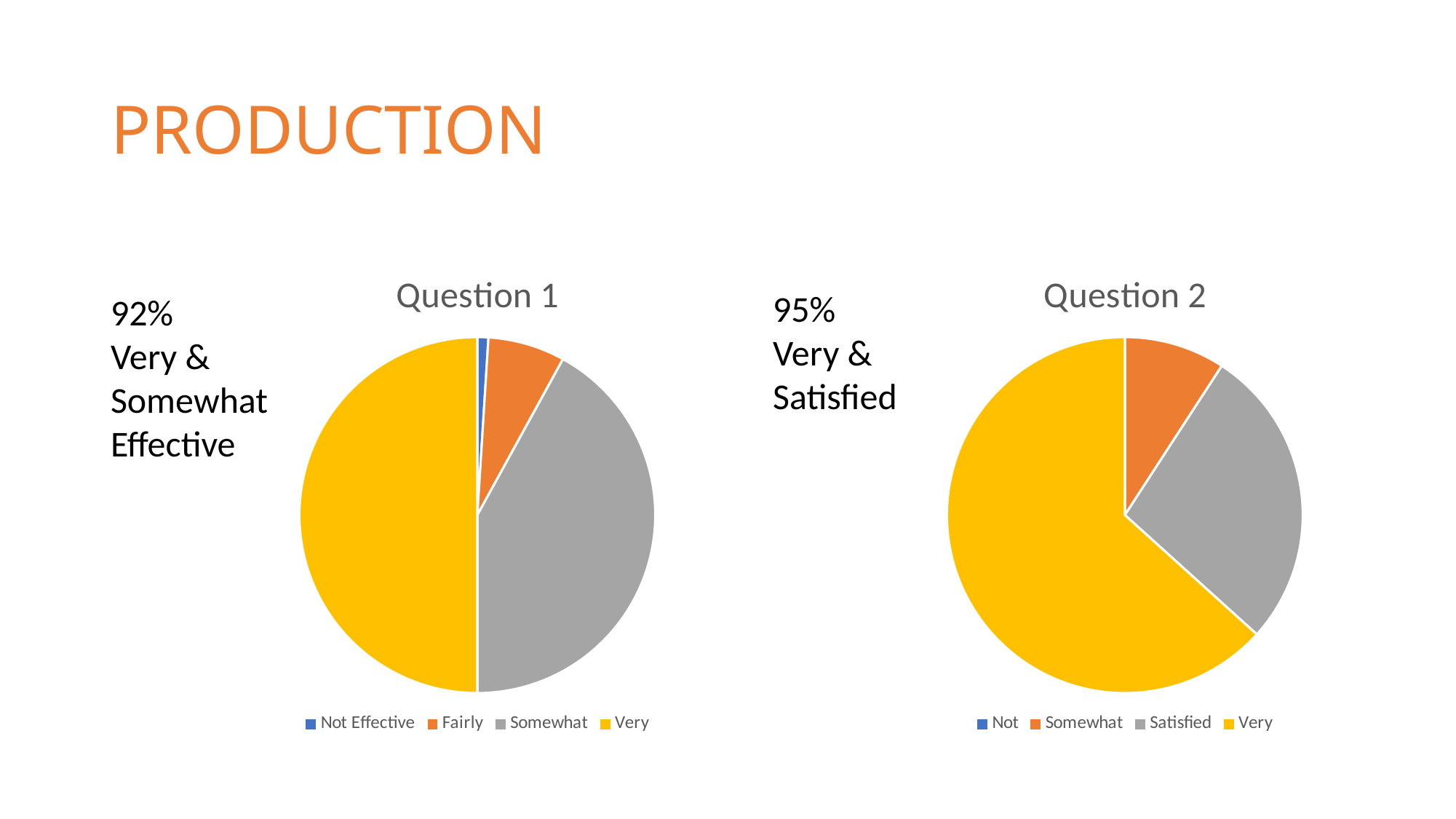
In the Question 1 chart, which category has the largest slice? Very In the Question 2 chart, which slice is larger, Very or Satisfied? Very In the Question 1 chart, which slice is larger, Somewhat or Fairly? Somewhat What colour is the Very slice in the Question 2 chart? yellow How many categories does the legend of the Question 2 chart list? 4 In the Question 1 chart, which category has the smallest slice? Not Effective In the Question 1 chart, which slice is larger, Very or Fairly? Very What kind of chart is the Question 2 chart? pie chart In the Question 2 chart, which category has the largest slice? Very What kind of chart is the Question 1 chart? pie chart How many categories does the legend of the Question 1 chart list? 4